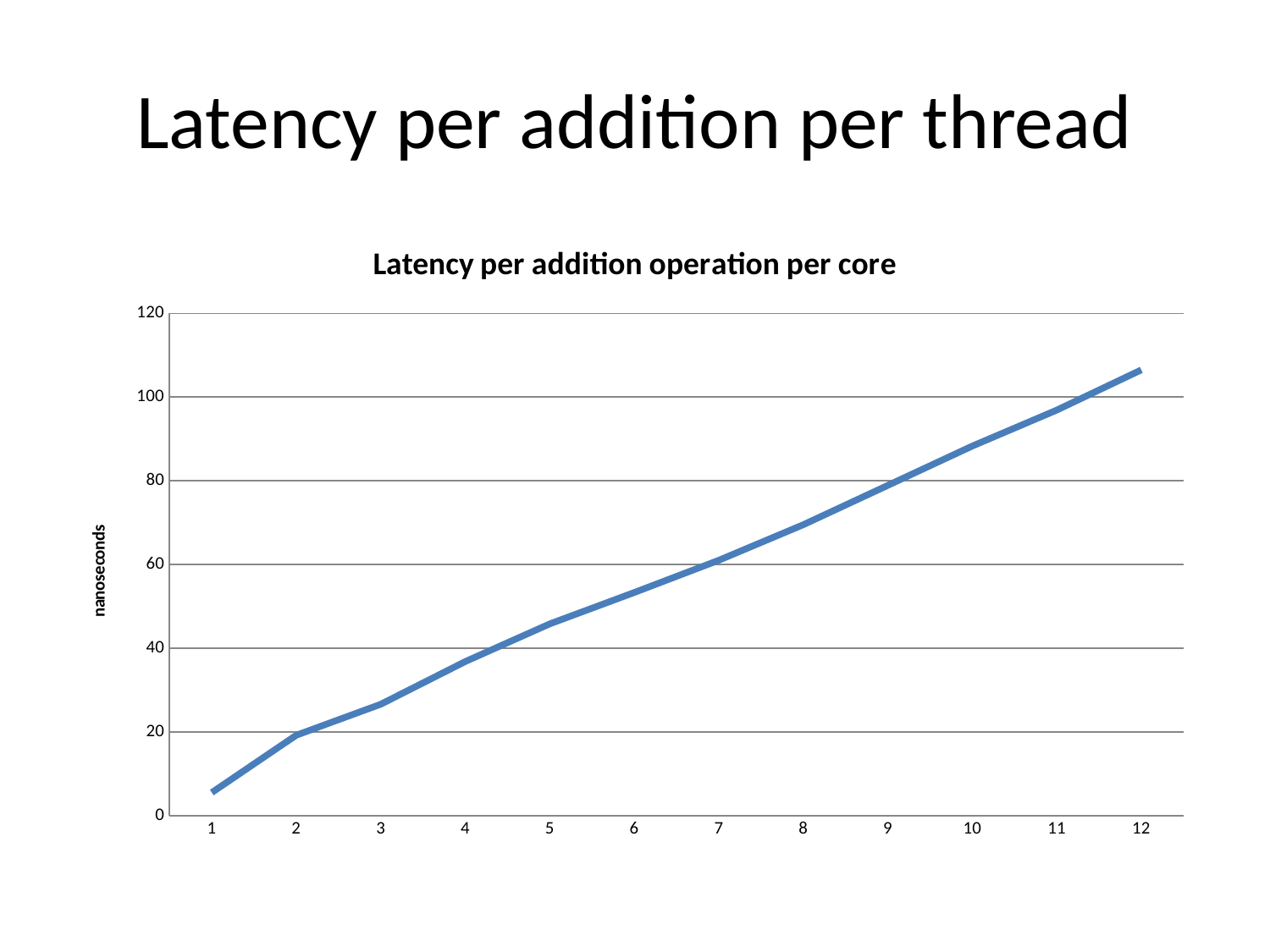
At which x-axis value is the latency highest? 12 What is the title of the chart? Latency per addition operation per core Is the value at 8 greater or less than 60? greater Which has the larger value, x = 3 or x = 10? 10 Is the value at 12 greater or less than 100? greater What is the label on the vertical axis of the chart? nanoseconds How many points are plotted along the x axis? 12 What kind of chart is shown on the slide? line chart Is the value at 5 greater or less than 40? greater At which x-axis value is the latency lowest? 1 Do the values rise or fall as the x axis goes from 1 to 12? rise